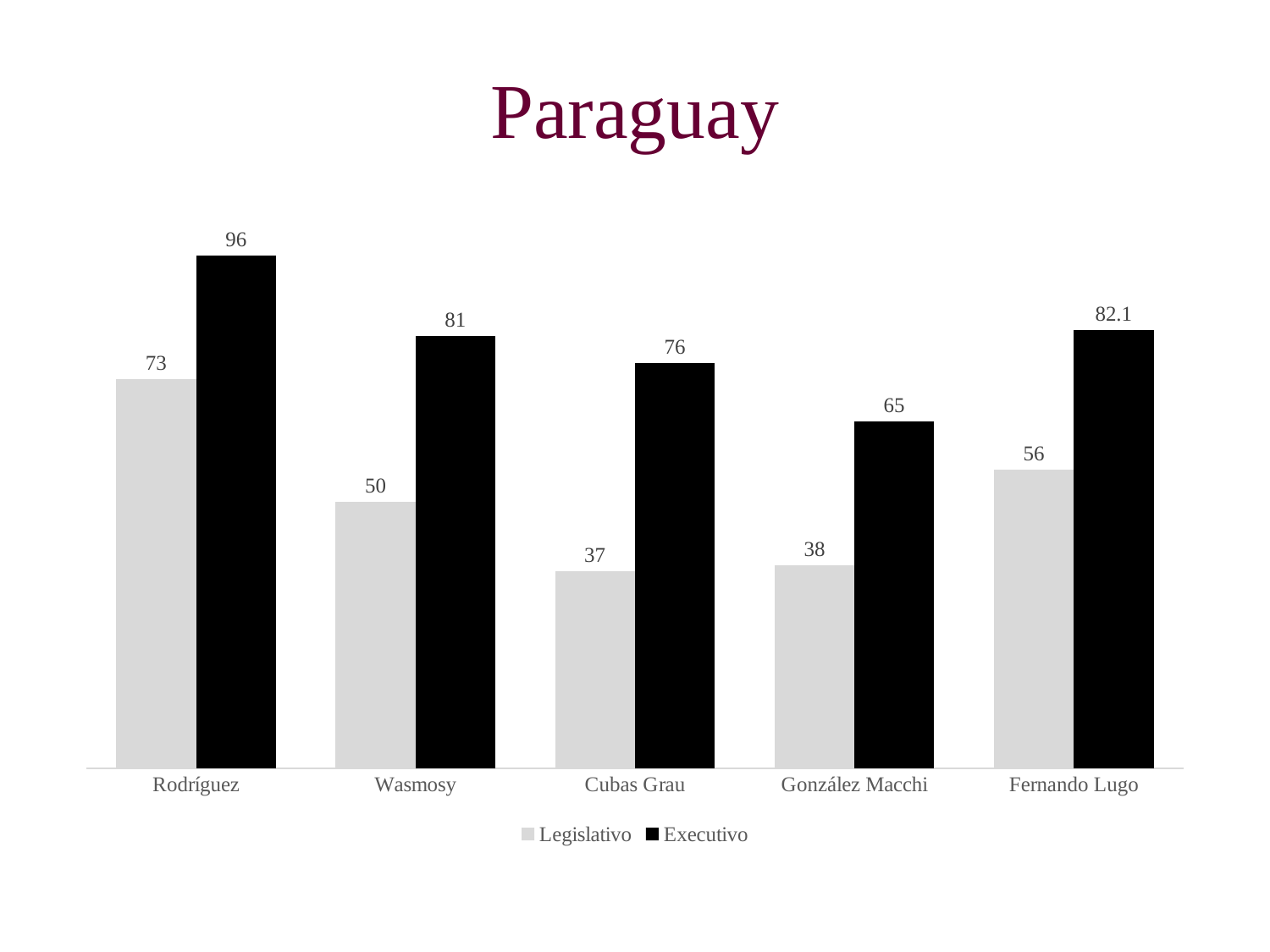
How many presidents are shown on the x axis? 5 What is the difference between the Executivo values for Rodríguez and González Macchi? 31 What is the Executivo value for Fernando Lugo? 82.1 What kind of chart is shown on the slide? Bar chart What is the Legislativo value for Rodríguez? 73 What is the difference between the Executivo and Legislativo values for Wasmosy? 31 Which president has the highest Executivo value? Rodríguez How many series does the legend list? 2 Which is larger, the Legislativo value for Fernando Lugo or the Legislativo value for Wasmosy? Fernando Lugo Which president has the lowest Legislativo value? Cubas Grau What is the Legislativo value for Cubas Grau? 37 What is the title of the slide? Paraguay